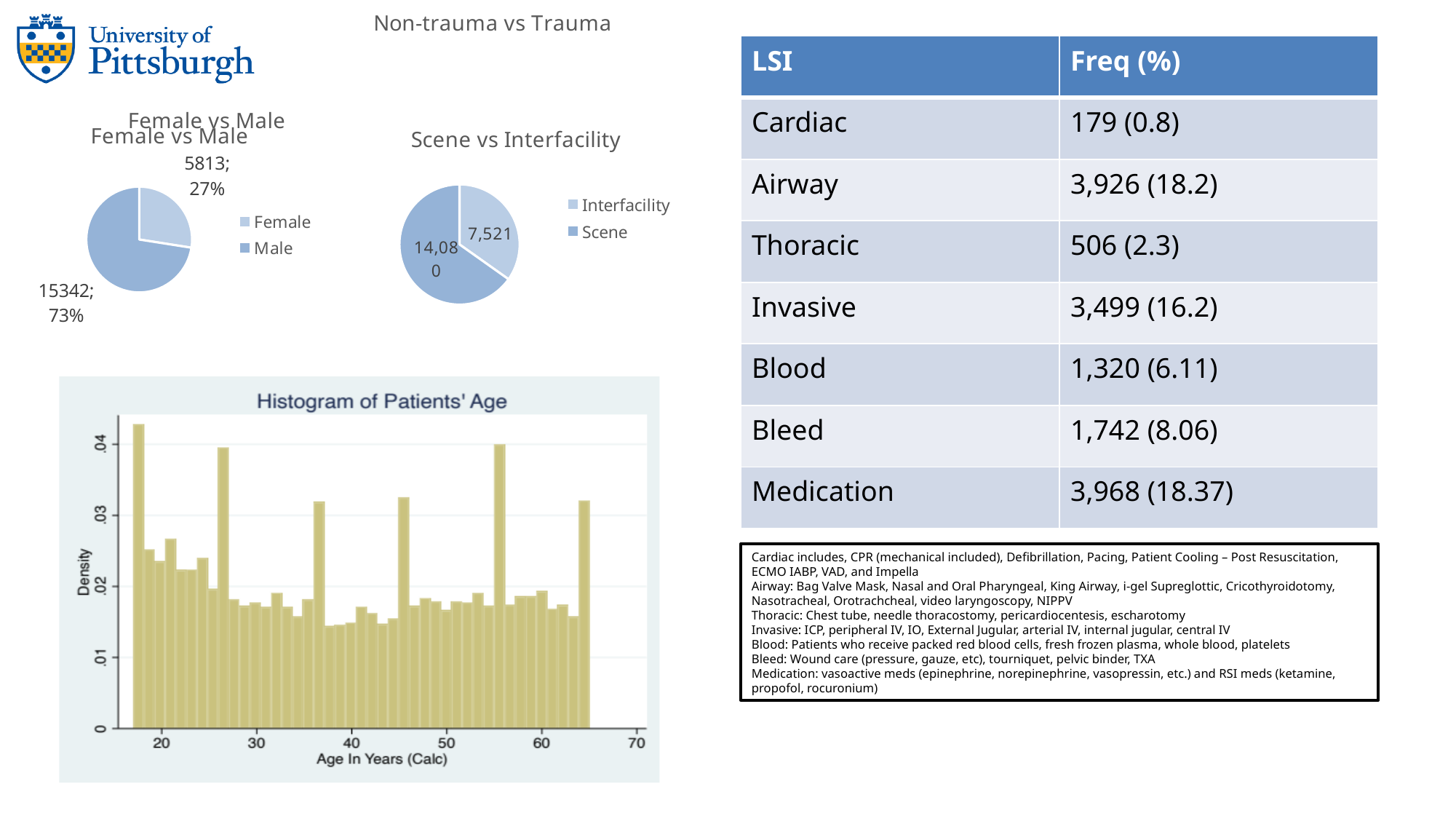
In the Scene vs Interfacility pie chart, what value is shown for Scene? 14,080 What is the x-axis label of the Histogram of Patients' Age chart? Age In Years (Calc) In the Female vs Male pie chart, which category is larger, Female or Male? Male In the Scene vs Interfacility pie chart, which category is the largest? Scene In the Scene vs Interfacility pie chart, what is the difference between the Scene and Interfacility values? 6,559 In the Scene vs Interfacility pie chart, what value is shown for Interfacility? 7,521 How many categories does the legend of the Scene vs Interfacility pie chart list? 2 In the Female vs Male pie chart, what value is shown for Female? 5813; 27% What kind of chart is the chart titled Histogram of Patients' Age? Histogram (bar chart) In the Female vs Male pie chart, what is the difference between the Male and Female counts? 9529 In the Female vs Male pie chart, what share of the pie is Male? 73% In the Female vs Male pie chart, what value is shown for Male? 15342; 73%